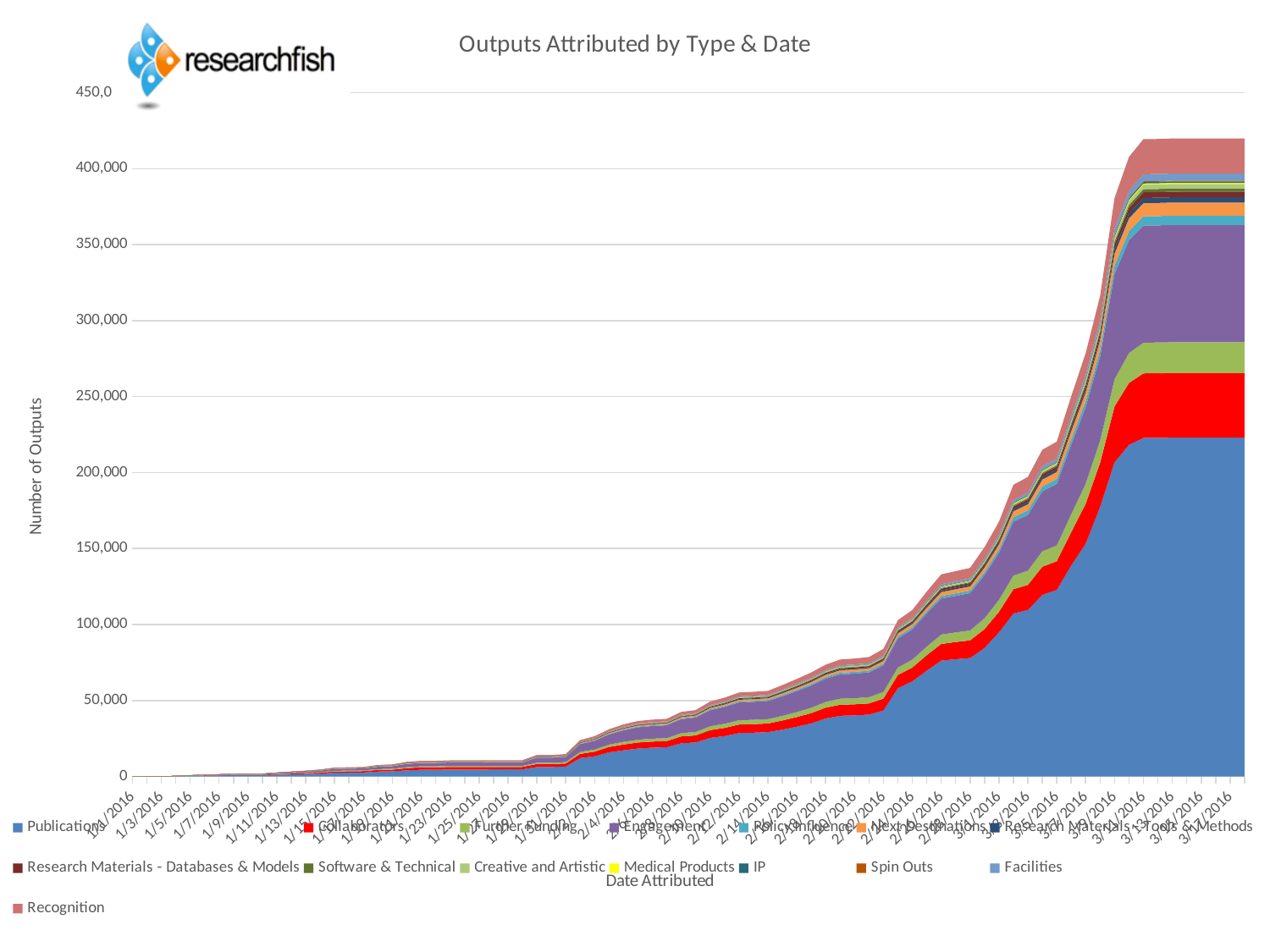
Is the total number of outputs at the end of the period greater or less than 400,000? greater At the end of the period, which series is larger: Engagement or Further Funding? Engagement Do the total outputs rise or fall over time along the x axis? Rise How many series does the legend list? 15 At the end of the period, which series is larger: Publications or Collaborators? Publications Which series accounts for the largest share of outputs at the end of the period? Publications Is the total number of outputs at the end of the period greater or less than 450,000? less What is the title of the chart? Outputs Attributed by Type & Date What is the highest value shown on the vertical axis? 450,000 Is the number of Publications at the end of the period greater or less than 200,000? greater What kind of chart is shown on the slide? Stacked area chart What is the label of the vertical axis? Number of Outputs